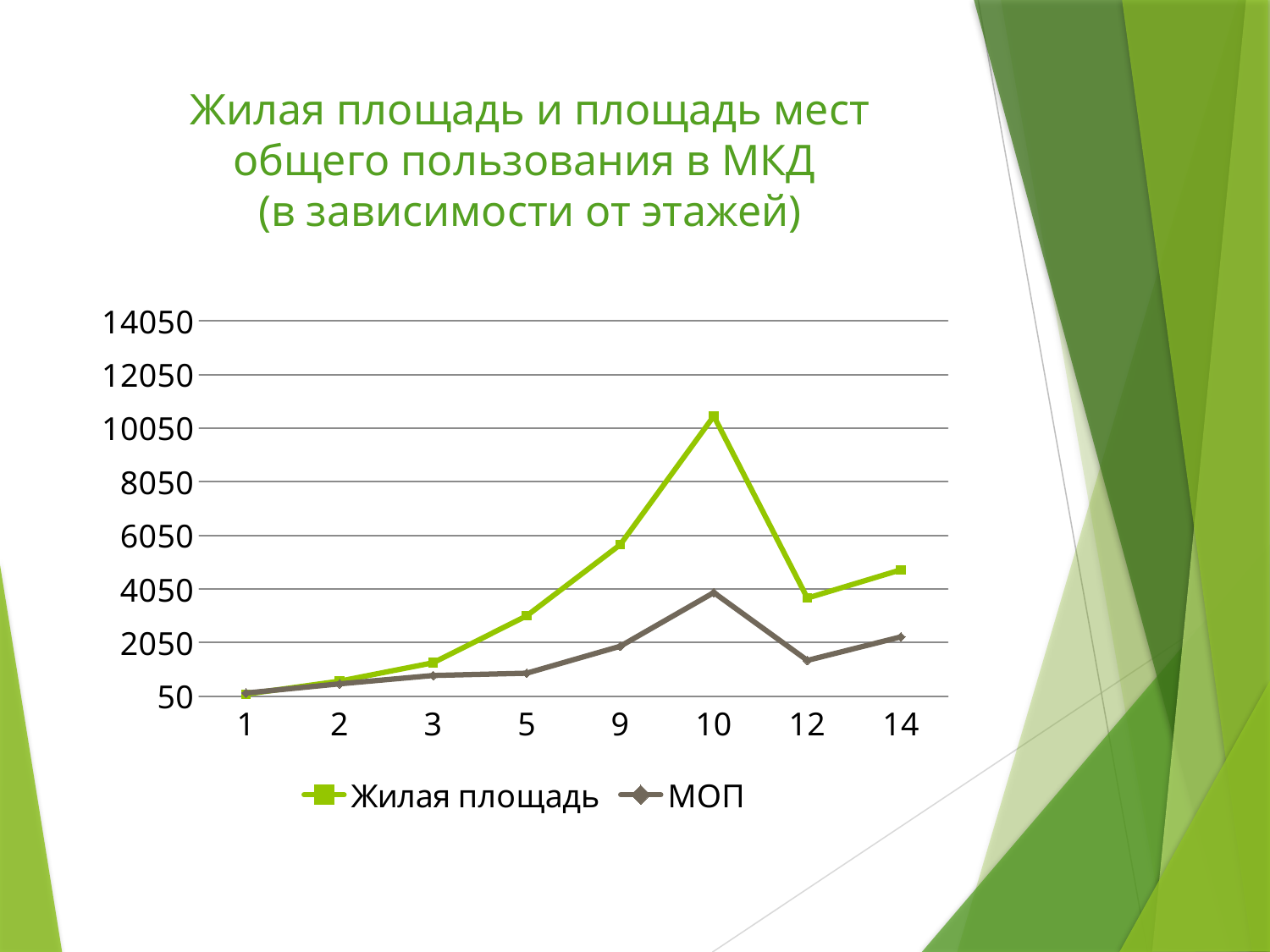
At which x-axis category is the Жилая площадь series lowest? 1 Does the Жилая площадь series rise or fall between categories 10 and 12? fall Is the value of МОП at category 12 greater or less than 2050? less How many categories are shown on the x axis? 8 Is the value of Жилая площадь at category 12 greater or less than 4050? less How many series does the legend list? 2 At which x-axis category does the МОП series reach its highest value? 10 What kind of chart is shown on the slide? line chart At which x-axis category does the Жилая площадь series reach its highest value? 10 Is the value of Жилая площадь at category 10 greater or less than 8050? greater At category 10, which series has the larger value, Жилая площадь or МОП? Жилая площадь